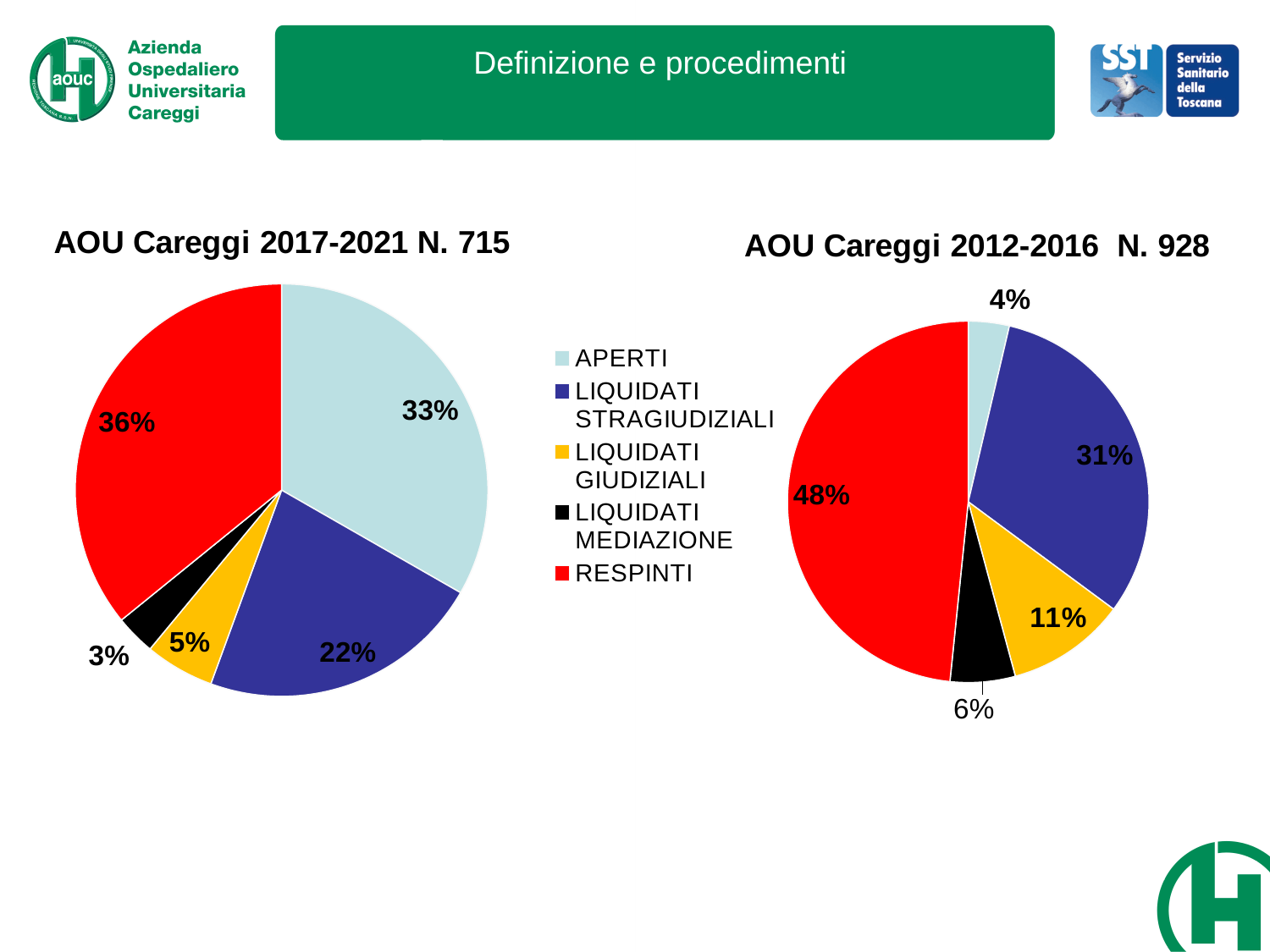
In the 'AOU Careggi 2017-2021 N. 715' pie chart, what share is APERTI? 33% In the 'AOU Careggi 2012-2016 N. 928' pie chart, what share is APERTI? 4% Which is larger: the LIQUIDATI STRAGIUDIZIALI share in the 2017-2021 chart or in the 2012-2016 chart? 2012-2016 In the 'AOU Careggi 2017-2021 N. 715' pie chart, what is the difference between the RESPINTI share and the LIQUIDATI STRAGIUDIZIALI share? 14% In the 'AOU Careggi 2017-2021 N. 715' pie chart, what share is LIQUIDATI MEDIAZIONE? 3% In the 'AOU Careggi 2012-2016 N. 928' pie chart, which category has the smallest share? APERTI In the 'AOU Careggi 2017-2021 N. 715' pie chart, which category has the largest share? RESPINTI How many categories does the legend list? 5 What kind of chart is used on this slide? Pie chart In the 'AOU Careggi 2012-2016 N. 928' pie chart, what share is RESPINTI? 48% In the 'AOU Careggi 2017-2021 N. 715' pie chart, what share is RESPINTI? 36% In the 'AOU Careggi 2012-2016 N. 928' pie chart, what share is LIQUIDATI GIUDIZIALI? 11%